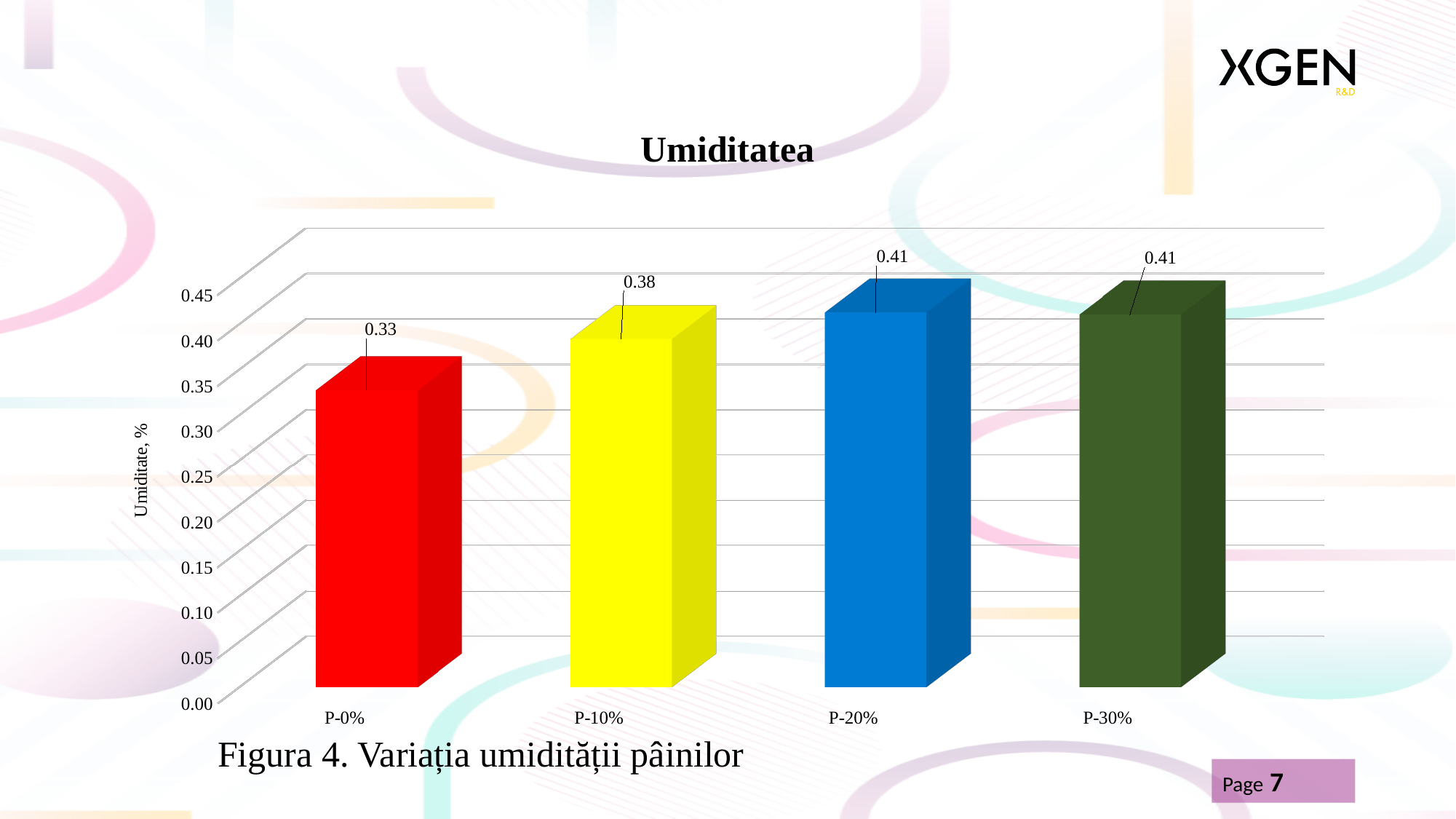
What is the difference between the values for P-10% and P-0%? 0.05 What is the value for P-10%? 0.38 What is the title of the chart? Umiditatea Do the values rise or fall from P-0% to P-20%? rise What is the value for P-30%? 0.41 How many categories are shown on the x axis? 4 Which is larger, the value for P-10% or the value for P-0%? P-10% What is the difference between the values for P-20% and P-10%? 0.03 What is the value for P-20%? 0.41 Which category has the lowest value? P-0% What kind of chart is shown on the slide? bar chart What is the value for P-0%? 0.33